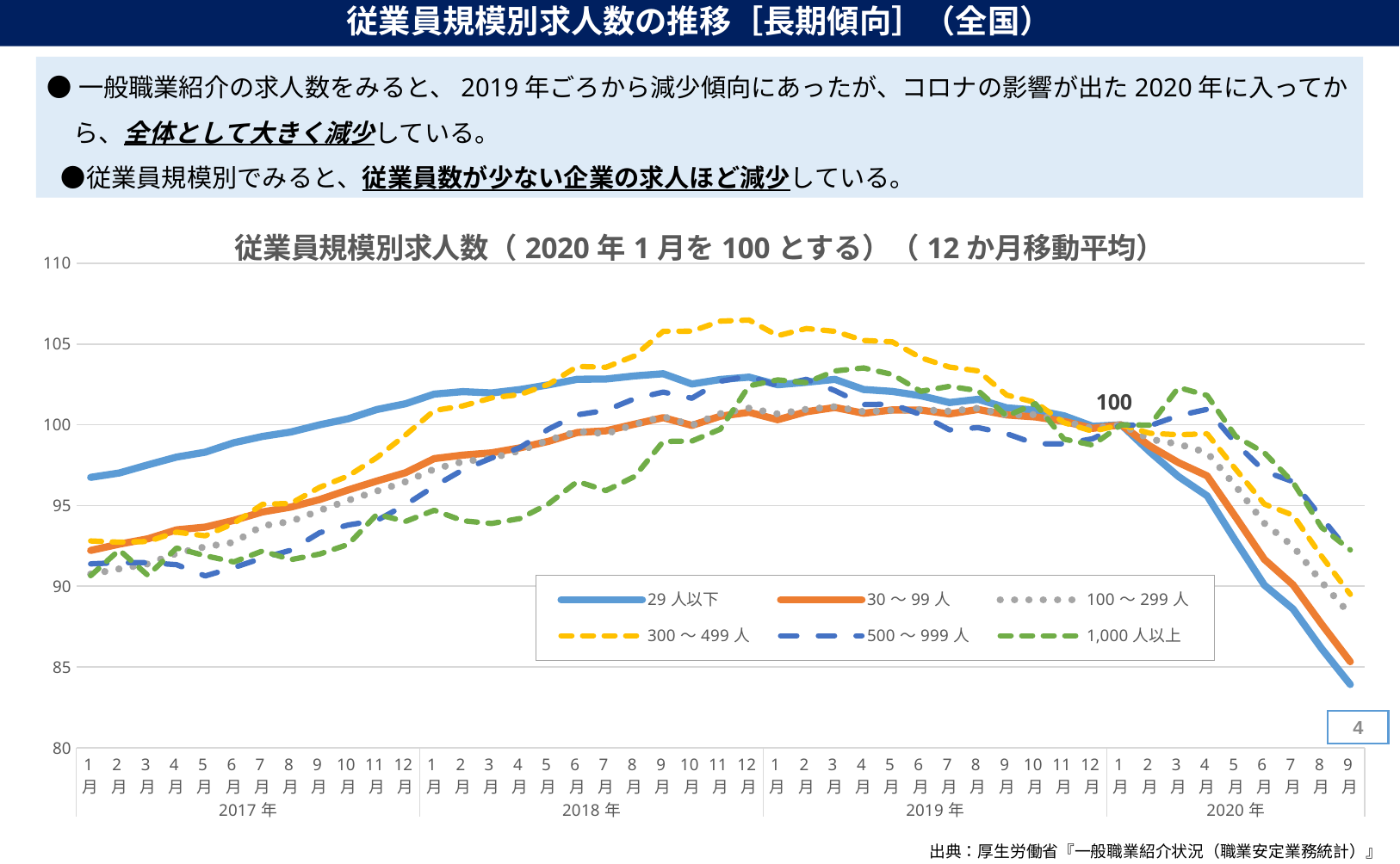
Is the value for 29人以下 in September 2020 (2020年9月) greater or less than 85? less Which series has the lowest value in September 2020 (2020年9月)? 29人以下 In January 2017 (2017年1月), which is larger: the value for 29人以下 or for 30～99人? 29人以下 How many series does the legend list? 6 Does the 29人以下 series rise or fall from January 2020 to September 2020? fall Which series is drawn as the solid orange line? 30～99人 What kind of chart is shown on the slide? line chart Is the value for 300～499人 in December 2018 (2018年12月) greater or less than 105? greater What value do the series take in January 2020 (2020年1月), as labelled on the chart? 100 Is the value for 29人以下 in January 2017 (2017年1月) greater or less than 95? greater How many years are labelled along the x axis? 4